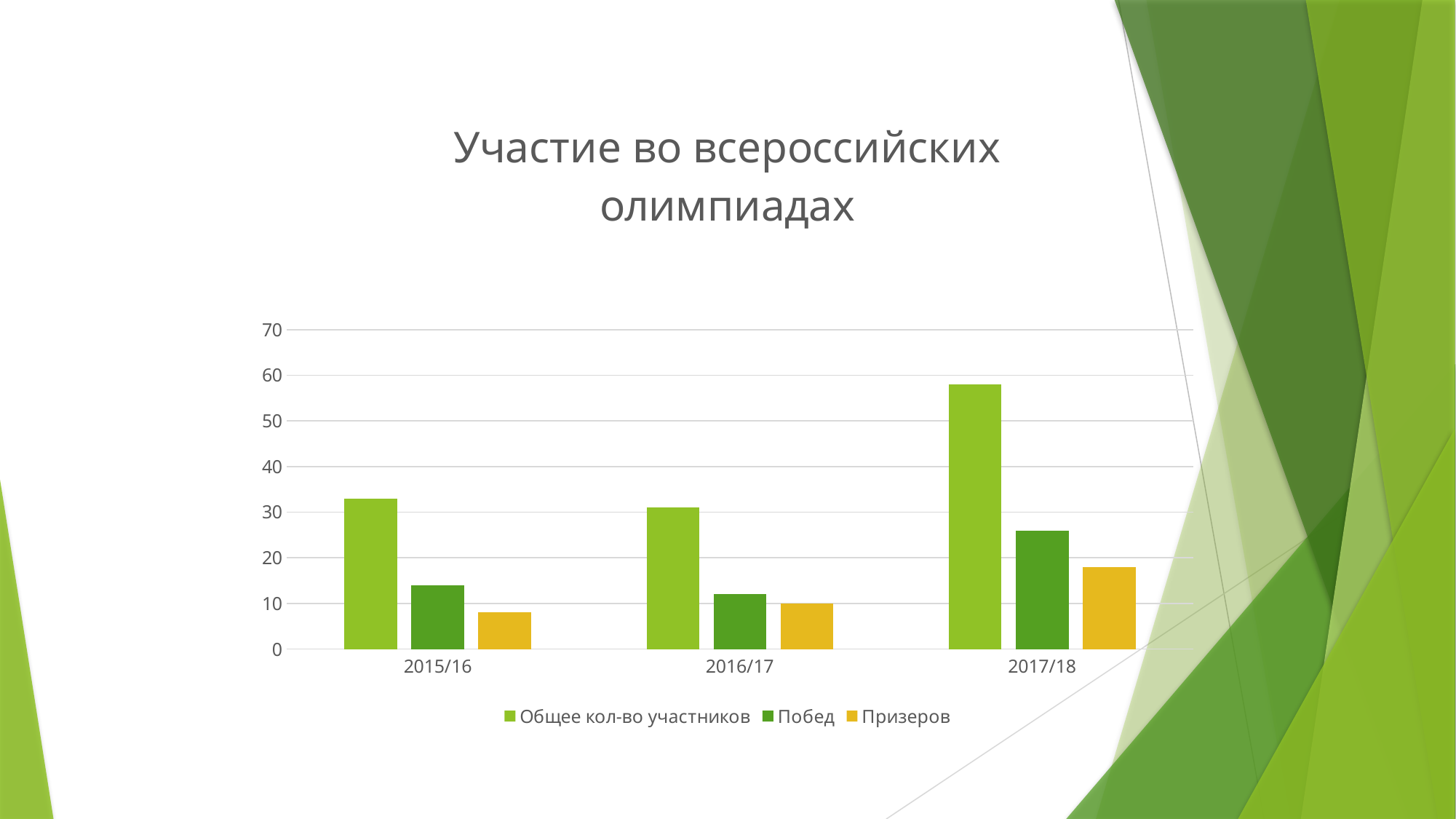
How many series does the legend list? 3 Which year has the lowest value for Призеров? 2015/16 Does the value for Побед rise or fall from 2016/17 to 2017/18? rise Which is larger: Побед in 2017/18 or Призеров in 2017/18? Побед in 2017/18 How many categories are shown on the x axis? 3 Which year has the highest value for Побед? 2017/18 Which year has the highest value for Общее кол-во участников? 2017/18 What is the title of the chart? Участие во всероссийских олимпиадах What kind of chart is shown on the slide? bar chart Is the value for Общее кол-во участников in 2016/17 greater or less than 40? less Is the value for Побед in 2015/16 greater or less than 20? less Is the value for Общее кол-во участников in 2017/18 greater or less than 50? greater